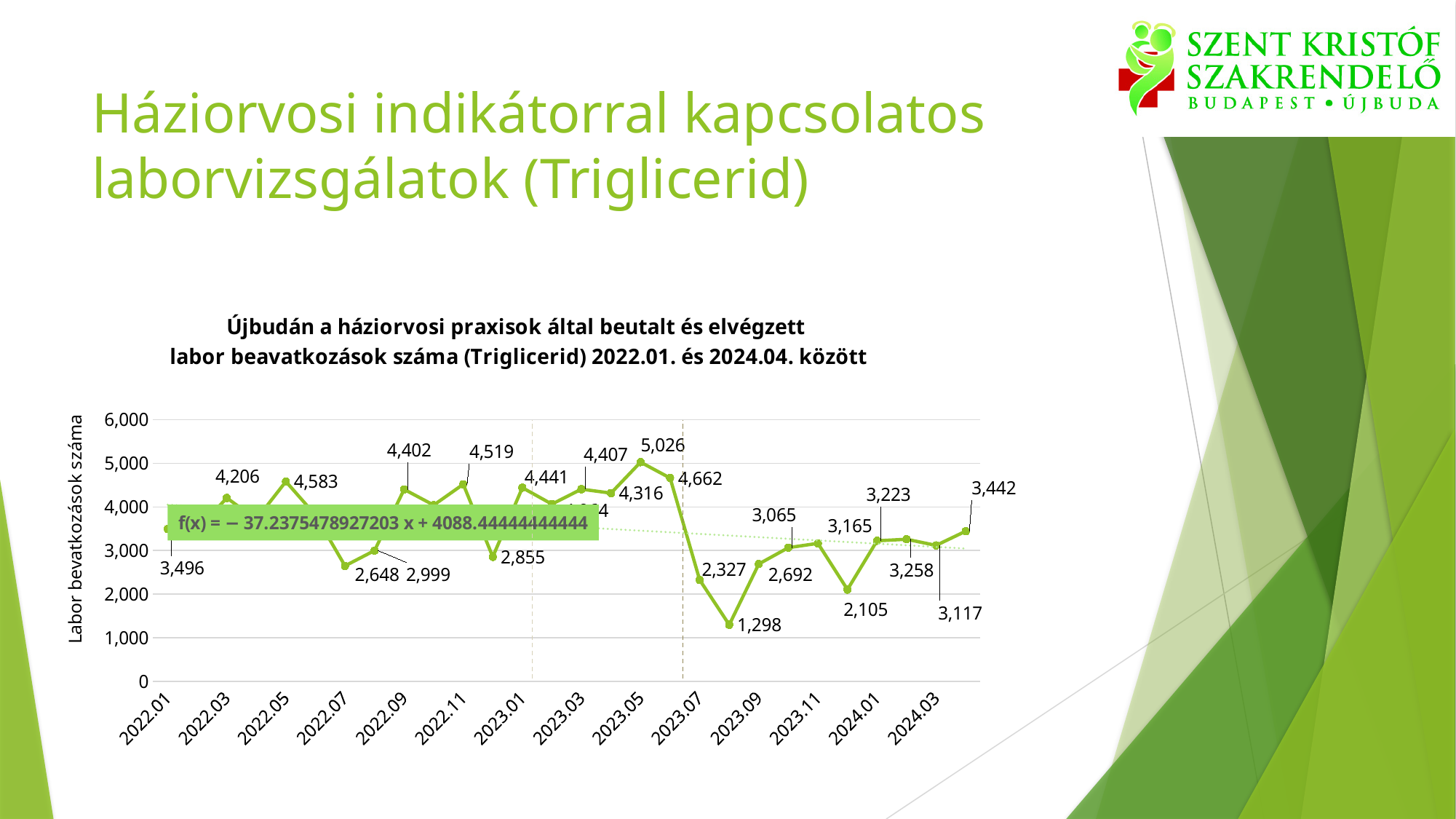
What is the value for 2022.05? 4,583 Which is larger, the value for 2022.01 or the value for 2024.04? 2022.01 What is the value for 2022.01? 3,496 What is the value for 2023.05? 5,026 What is the label of the vertical axis? Labor beavatkozások száma What is the value for the last point, 2024.04? 3,442 Is the value for 2022.07 greater or less than 3,000? less What is the lowest value plotted on the chart? 1,298 What is the difference between the highest value (5,026) and the lowest value (1,298)? 3,728 What is the highest value plotted on the chart? 5,026 What kind of chart is shown on the slide? line chart According to the dotted trend line, do the values rise or fall over the period? fall